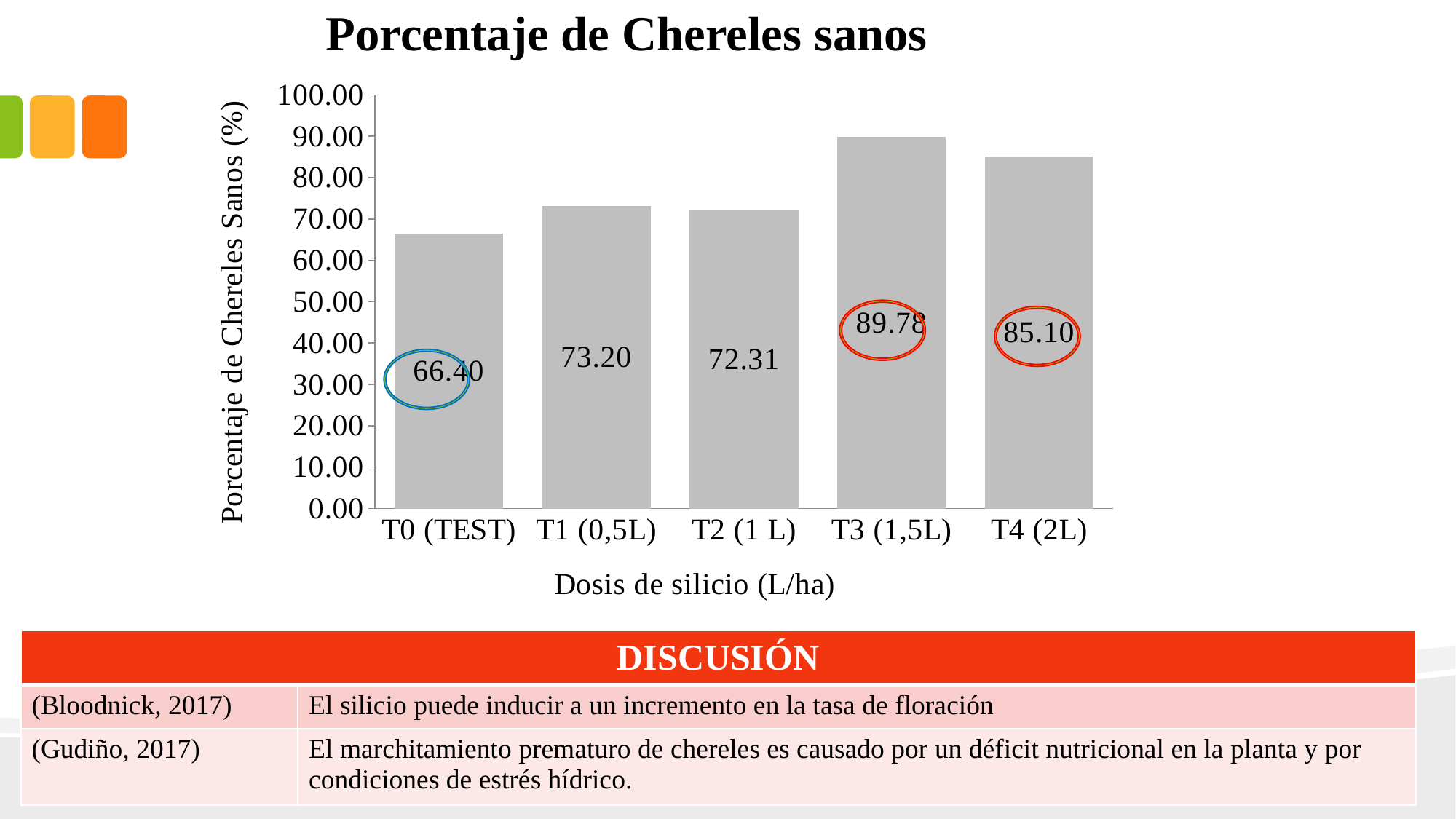
What is the difference between the values for T1 (0,5L) and T2 (1 L)? 0.89 What is the value for T3 (1,5L)? 89.78 What is the difference between the values for T3 (1,5L) and T0 (TEST)? 23.38 What is the value for T0 (TEST)? 66.40 Is the value for T2 (1 L) greater or less than 80.00? less What is the value for T4 (2L)? 85.10 How many categories are shown on the x axis? 5 Which category has the lowest value? T0 (TEST) Which category has the highest value? T3 (1,5L) What kind of chart is shown? bar chart What is the title of the chart? Porcentaje de Chereles sanos Which is larger, the value for T1 (0,5L) or the value for T4 (2L)? T4 (2L)